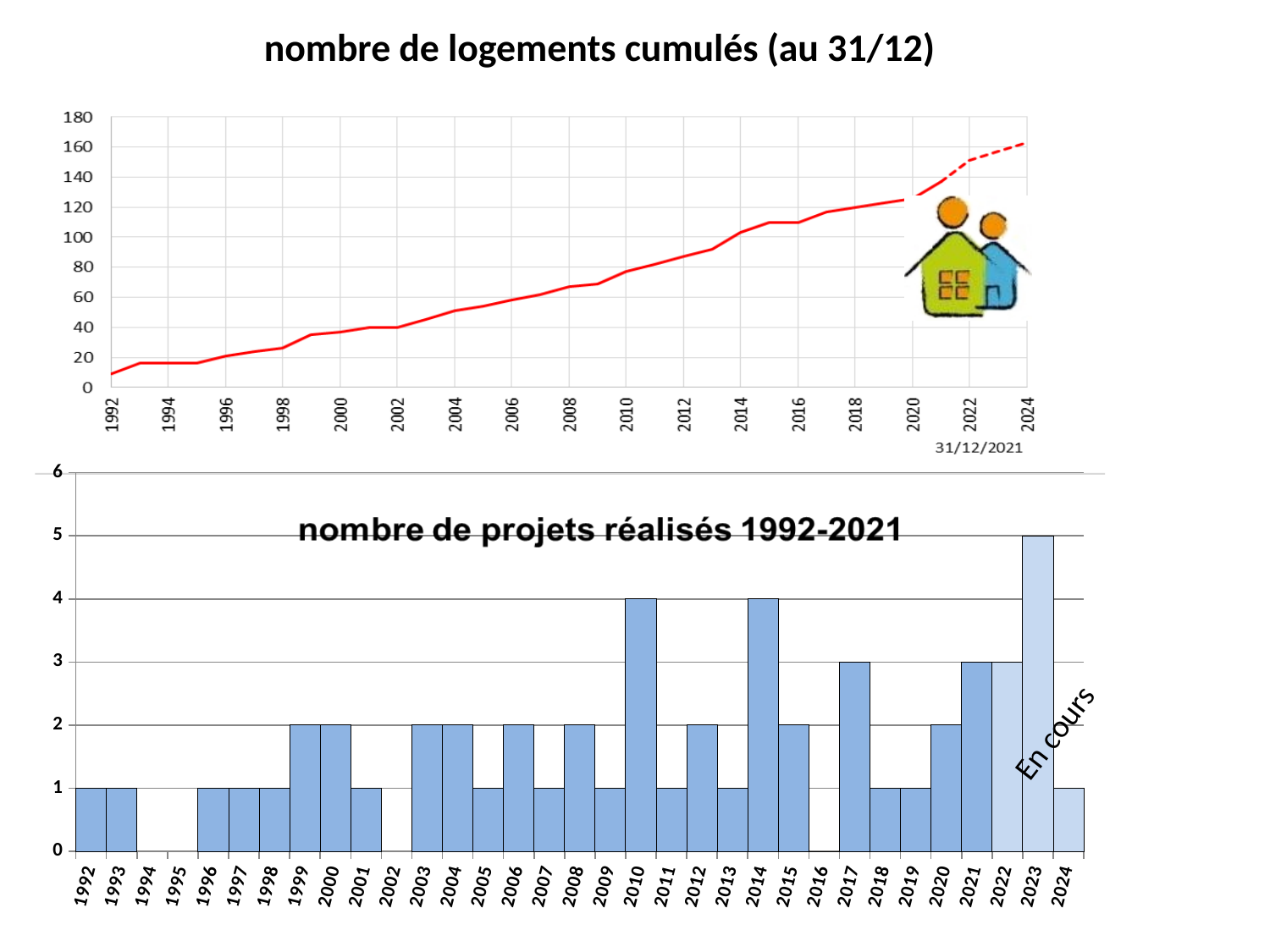
In the bar chart 'nombre de projets réalisés 1992-2021', which year has the highest bar? 2023 What kind of chart is 'nombre de logements cumulés (au 31/12)'? line chart In the bar chart 'nombre de projets réalisés 1992-2021', how many projects were completed in 2010? 4 In the bar chart 'nombre de projets réalisés 1992-2021', what is the value for 2023? 5 In the bar chart 'nombre de projets réalisés 1992-2021', how many years are shown on the x axis? 33 In the bar chart 'nombre de projets réalisés 1992-2021', what is the difference between the values for 2014 and 2015? 2 In the line chart 'nombre de logements cumulés (au 31/12)', do the values rise or fall from 1992 to 2024? rise In the bar chart 'nombre de projets réalisés 1992-2021', what is the value for 2017? 3 In the bar chart 'nombre de projets réalisés 1992-2021', which year has the larger value, 2021 or 2020? 2021 In the line chart 'nombre de logements cumulés (au 31/12)', is the value for 1992 greater or less than 20? less What kind of chart is 'nombre de projets réalisés 1992-2021'? bar chart In the line chart 'nombre de logements cumulés (au 31/12)', is the value for 2020 greater or less than 100? greater